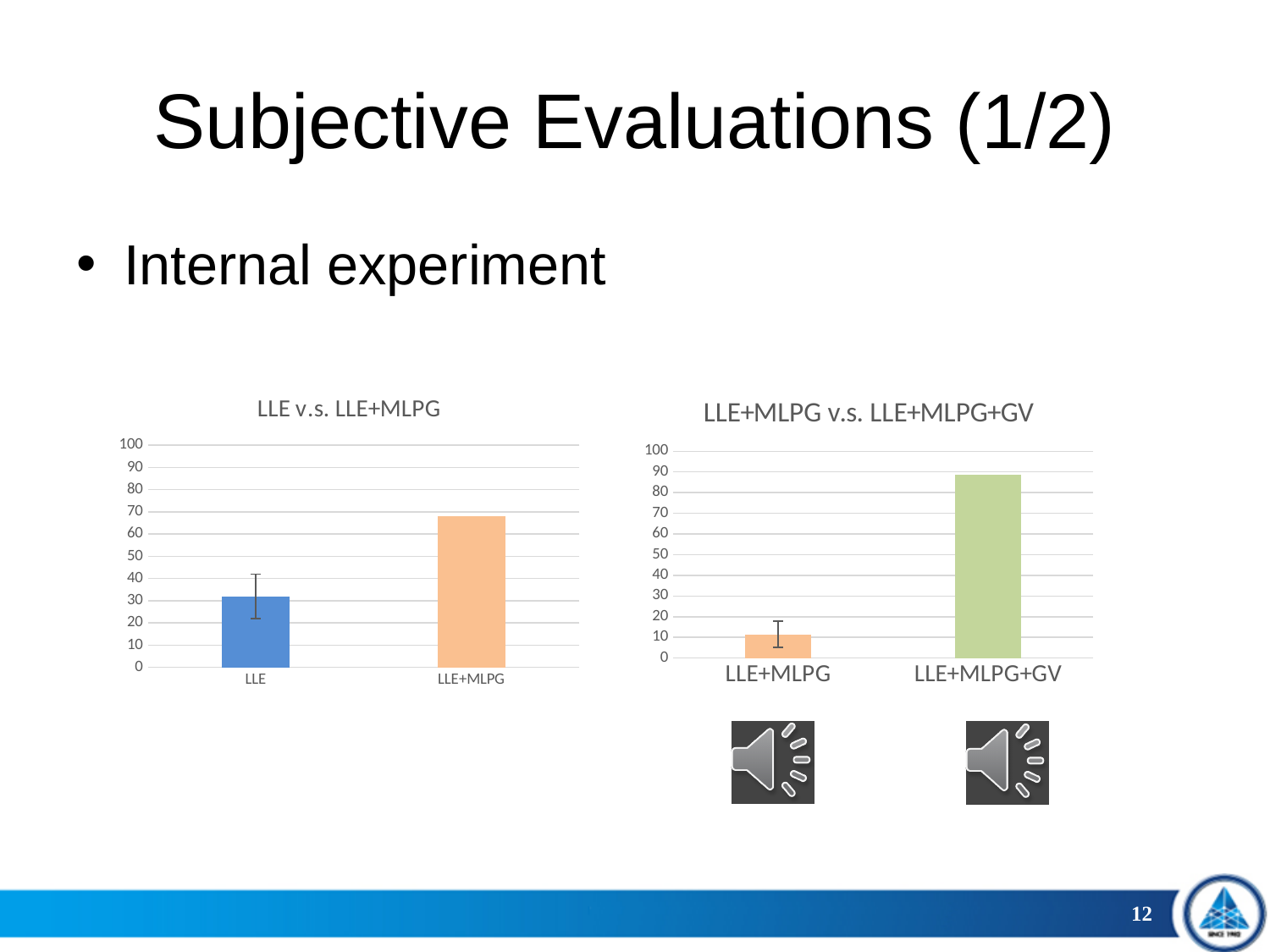
How many categories are shown in the chart titled "LLE v.s. LLE+MLPG"? 2 What is the title of the chart on the left side of the slide? LLE v.s. LLE+MLPG In the chart titled "LLE v.s. LLE+MLPG", is the value for LLE+MLPG greater or less than 60? greater What kind of chart is the chart titled "LLE+MLPG v.s. LLE+MLPG+GV"? bar chart In the chart titled "LLE+MLPG v.s. LLE+MLPG+GV", which category has the highest bar? LLE+MLPG+GV In the chart titled "LLE v.s. LLE+MLPG", which category has the higher bar? LLE+MLPG In the chart titled "LLE v.s. LLE+MLPG", which category has the lower bar? LLE In the chart titled "LLE v.s. LLE+MLPG", is the value for LLE greater or less than 40? less In the chart titled "LLE+MLPG v.s. LLE+MLPG+GV", which is larger, the value for LLE+MLPG or the value for LLE+MLPG+GV? LLE+MLPG+GV In the chart titled "LLE+MLPG v.s. LLE+MLPG+GV", is the value for LLE+MLPG greater or less than 20? less In the chart titled "LLE+MLPG v.s. LLE+MLPG+GV", which category has the lowest bar? LLE+MLPG